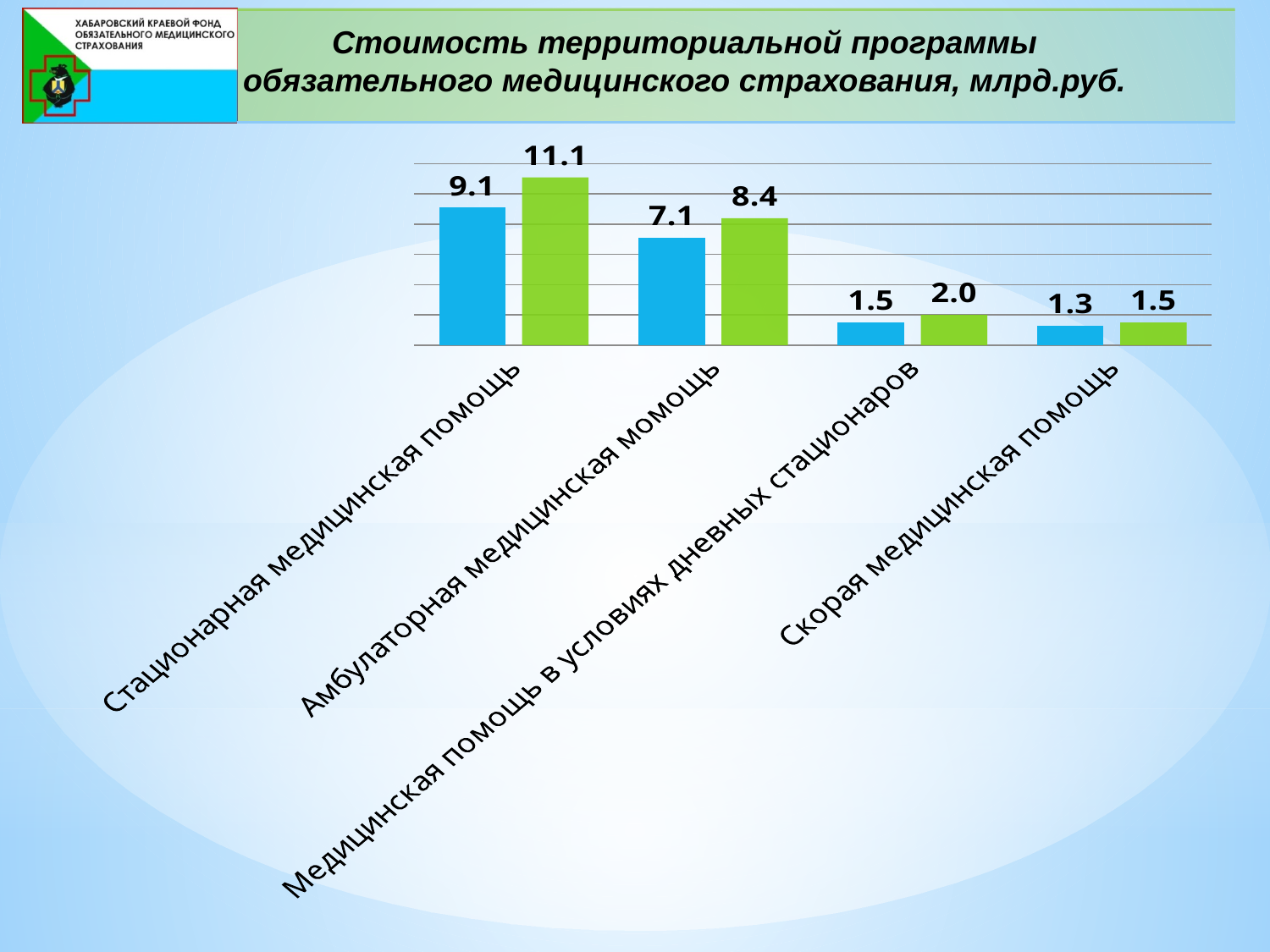
What is the value of the blue bar for Скорая медицинская помощь? 1.3 What kind of chart is shown on the slide? bar chart Which is larger for Скорая медицинская помощь, the blue bar or the green bar? the green bar How many categories are shown on the x axis? 4 What is the value of the green bar for Медицинская помощь в условиях дневных стационаров? 2.0 What is the difference between the green and blue bars for Стационарная медицинская помощь? 2.0 What is the difference between the green and blue bars for Амбулаторная медицинская помощь? 1.3 What is the value of the blue bar for Стационарная медицинская помощь? 9.1 What is the value of the green bar for Стационарная медицинская помощь? 11.1 What is the value of the blue bar for Амбулаторная медицинская помощь? 7.1 Which category has the highest green bar? Стационарная медицинская помощь Which category has the lowest blue bar? Скорая медицинская помощь